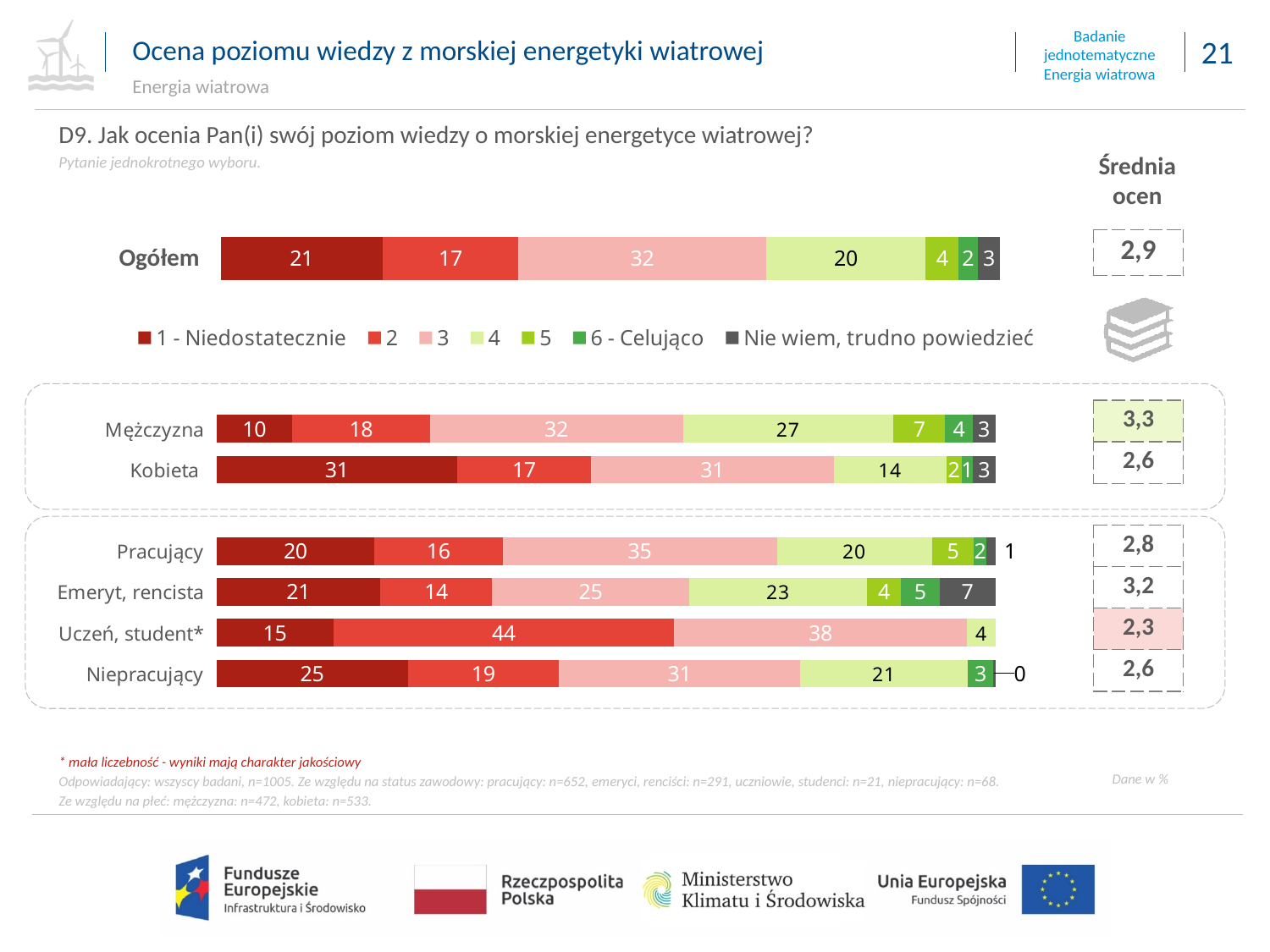
Which group has the lowest average rating (Średnia ocen) on the slide? Uczeń, student* In the bottom chart, what is the value for '2' for Uczeń, student*? 44 In the middle chart, what is the value for '1 - Niedostatecznie' for Kobieta? 31 How many groups are shown in the bottom chart (employment status)? 4 Which group in the bottom chart has the highest value for '3'? Uczeń, student* In the middle chart, what is the difference between the '4' values for Mężczyzna and Kobieta? 13 In the middle chart, which group has the lower value for '1 - Niedostatecznie', Mężczyzna or Kobieta? Mężczyzna In the bottom chart, what is the value for 'Nie wiem, trudno powiedzieć' for Emeryt, rencista? 7 What is the average rating (Średnia ocen) shown for Mężczyzna? 3,3 How many series does the legend list? 7 What kind of chart is used on this slide? Stacked bar chart In the top chart (Ogółem), what percentage of respondents rated their knowledge as 3? 32